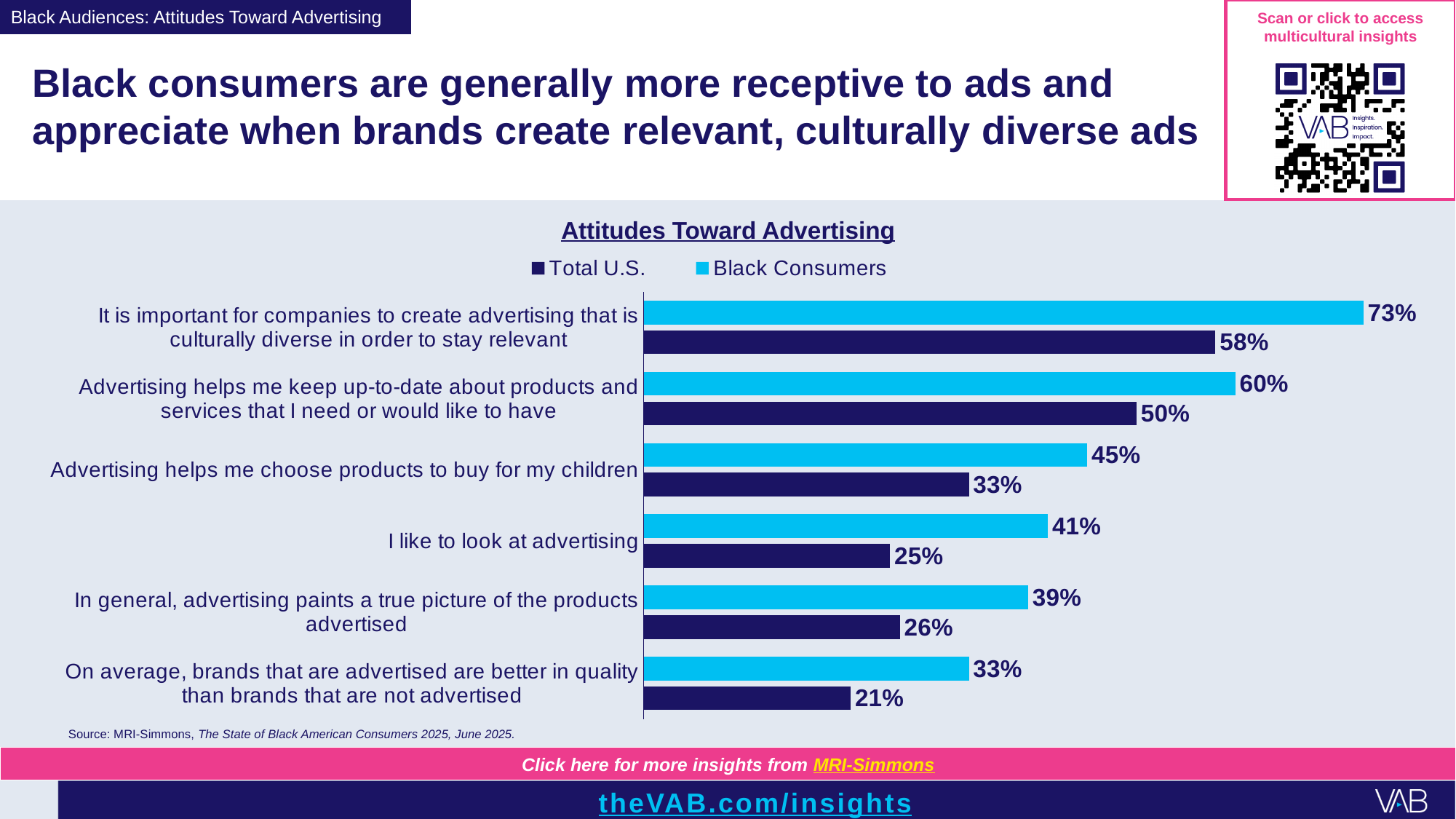
What is the Total U.S. value for "Advertising helps me choose products to buy for my children"? 33% What is the difference between the Black Consumers and Total U.S. values for "I like to look at advertising"? 16% How many series does the legend list? 2 What is the title of the chart? Attitudes Toward Advertising What is the difference between the Black Consumers and Total U.S. values for "It is important for companies to create advertising that is culturally diverse in order to stay relevant"? 15% What type of chart is shown on the slide? Bar chart What is the Total U.S. value for "On average, brands that are advertised are better in quality than brands that are not advertised"? 21% How many statements (categories) are shown in the chart? 6 Which statement has the lowest Total U.S. value? On average, brands that are advertised are better in quality than brands that are not advertised Which statement has the highest Black Consumers value? It is important for companies to create advertising that is culturally diverse in order to stay relevant For "In general, advertising paints a true picture of the products advertised", which series has the larger value, Total U.S. or Black Consumers? Black Consumers What is the Black Consumers value for "I like to look at advertising"? 41%